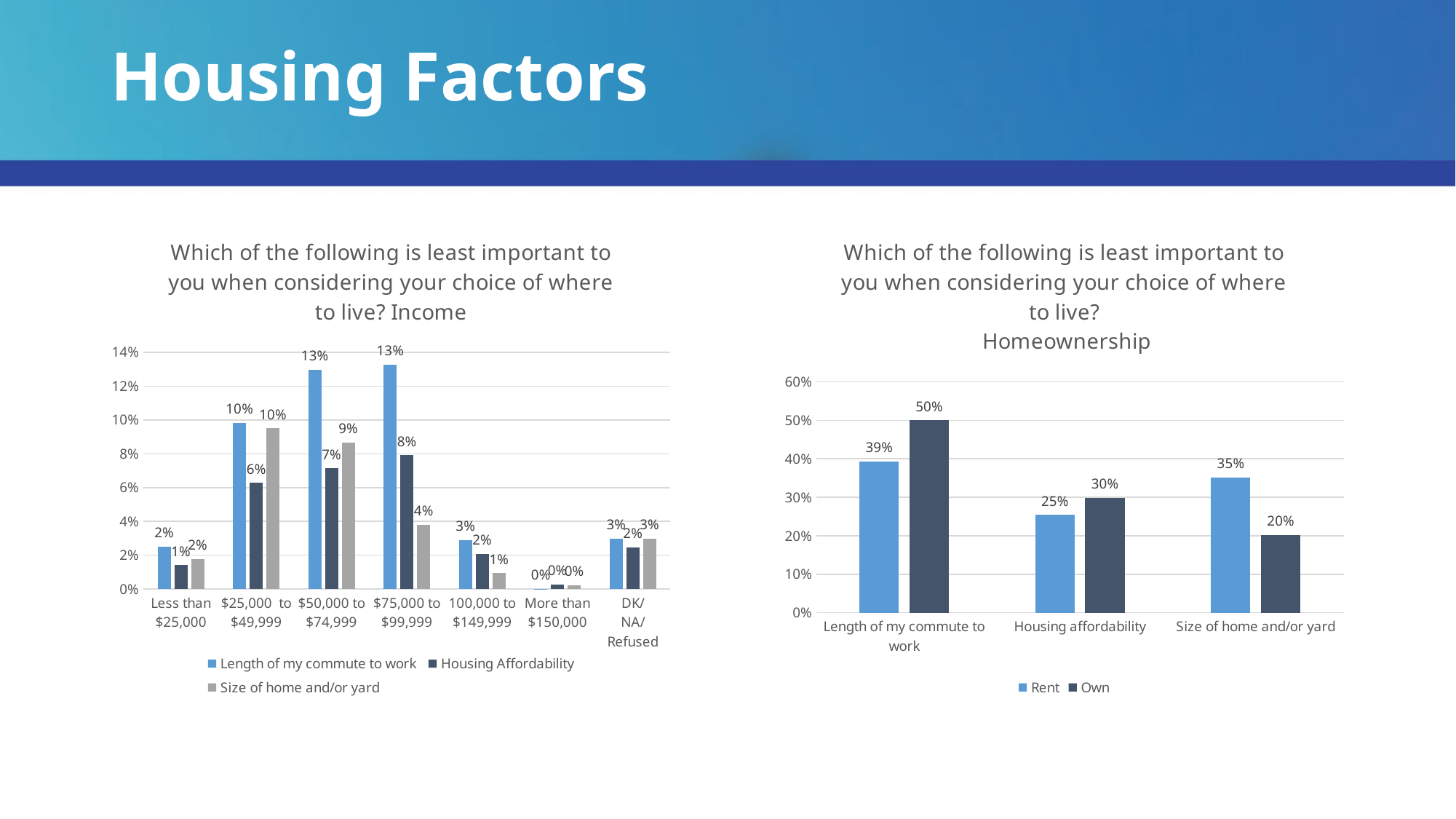
In the Income chart on the left, how many income categories are shown on the x axis? 7 In the Homeownership chart on the right, how many series does the legend list? 2 In the Homeownership chart on the right, what is the difference between Rent and Own for Housing affordability? 5% In the Income chart on the left, what is the difference between Length of my commute to work and Housing Affordability for $50,000 to $74,999? 6% In the Income chart on the left, what is the value for Housing Affordability for $75,000 to $99,999? 8% In the Income chart on the left, what is the value for Size of home and/or yard for $50,000 to $74,999? 9% In the Homeownership chart on the right, which category has the highest Own value? Length of my commute to work In the Homeownership chart on the right, what is the value for Rent for Size of home and/or yard? 35% In the Income chart on the left, which income category has the lowest value for Length of my commute to work? More than $150,000 In the Homeownership chart on the right, what is the value for Own for Length of my commute to work? 50% In the Homeownership chart on the right, for Size of home and/or yard, which is larger, Rent or Own? Rent What type of chart is the Income chart on the left? Bar chart